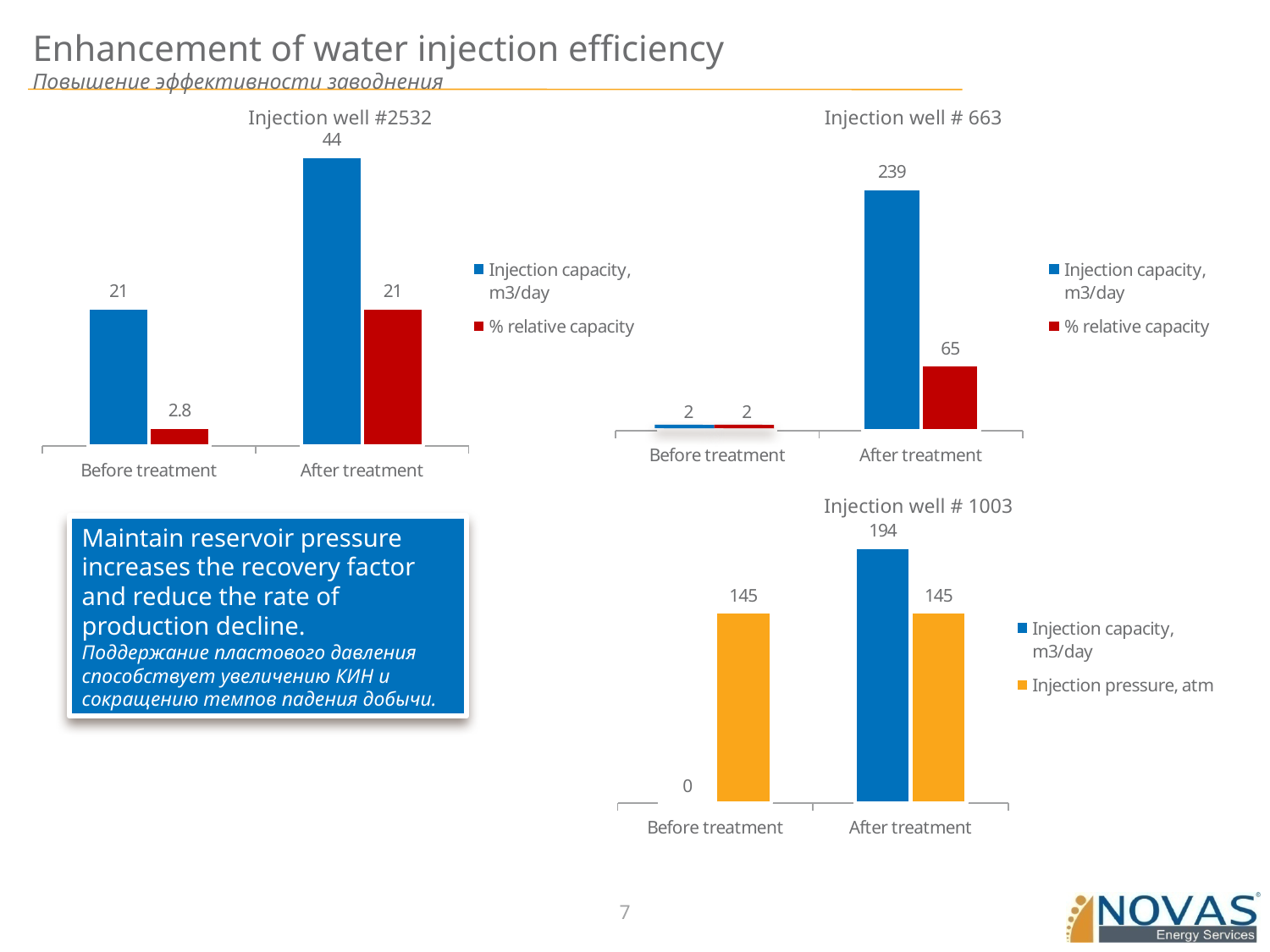
In the 'Injection well # 663' chart, what is the % relative capacity after treatment? 65 What type of chart is 'Injection well # 663'? Bar chart In the 'Injection well # 663' chart, what is the injection capacity (m3/day) before treatment? 2 In the 'Injection well # 1003' chart, what is the injection pressure (atm) after treatment? 145 In the 'Injection well # 1003' chart, which is larger after treatment: injection capacity or injection pressure? Injection capacity In the 'Injection well #2532' chart, what is the % relative capacity before treatment? 2.8 In the 'Injection well # 663' chart, what is the injection capacity (m3/day) after treatment? 239 How many categories are shown on the x axis of the 'Injection well #2532' chart? 2 In the 'Injection well # 1003' chart, what is the injection capacity (m3/day) before treatment? 0 How many series does the legend of the 'Injection well # 1003' chart list? 2 In the 'Injection well #2532' chart, what is the injection capacity (m3/day) after treatment? 44 In the 'Injection well #2532' chart, by how much did injection capacity (m3/day) increase from before to after treatment? 23